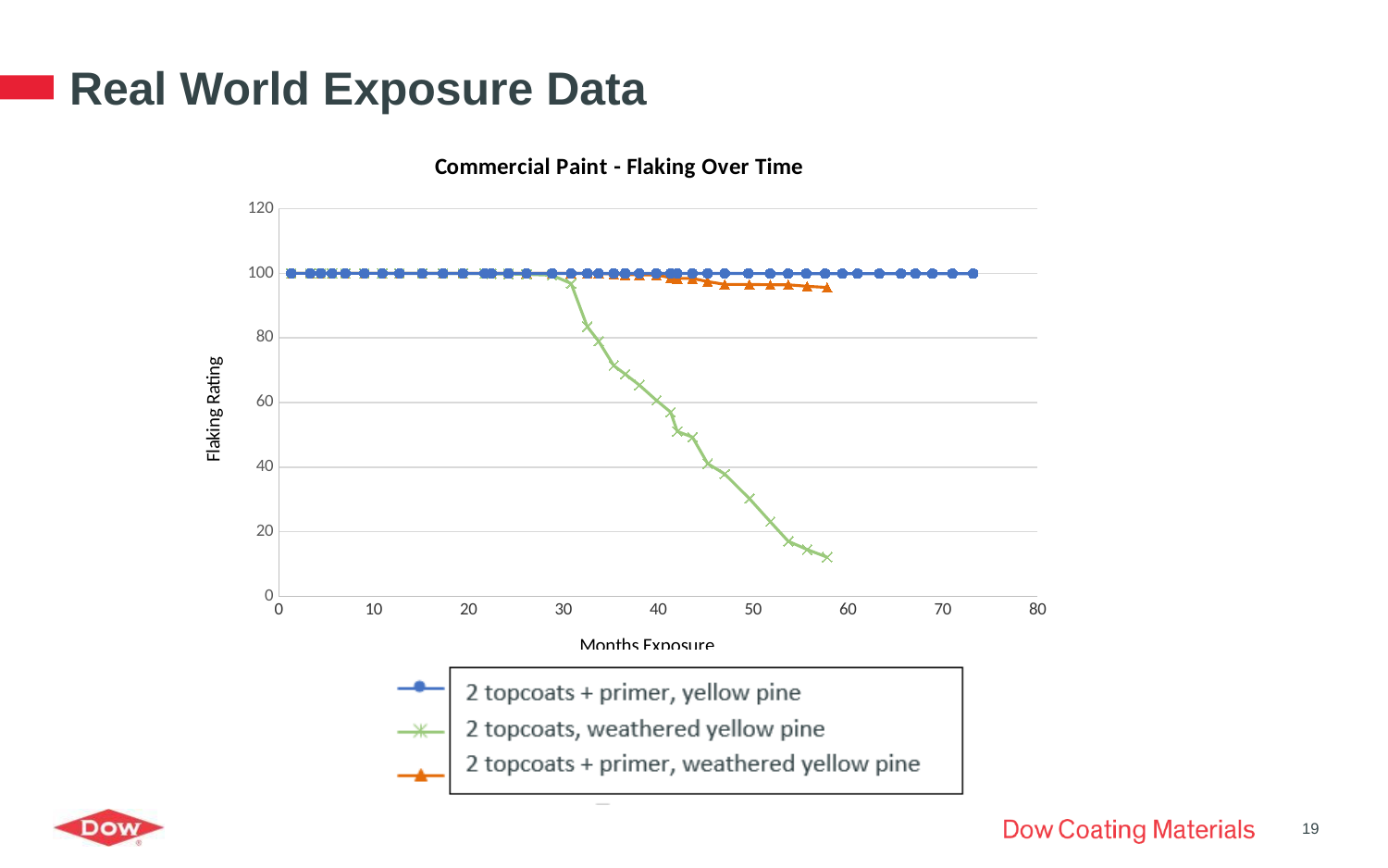
Is the flaking rating for '2 topcoats, weathered yellow pine' at 50 months exposure greater or less than 40? less What is the title of the chart? Commercial Paint - Flaking Over Time What is the label of the vertical axis? Flaking Rating Is the flaking rating for '2 topcoats + primer, weathered yellow pine' at 55 months exposure greater or less than 80? greater Which series reaches the lowest flaking rating on the chart? 2 topcoats, weathered yellow pine How many series does the legend list? 3 Is the flaking rating for '2 topcoats + primer, yellow pine' at 70 months exposure greater or less than 80? greater What kind of chart is shown on the slide? line chart Does the flaking rating for '2 topcoats, weathered yellow pine' rise or fall as months of exposure increase beyond 30? fall At 50 months exposure, which series has the higher flaking rating: '2 topcoats + primer, yellow pine' or '2 topcoats, weathered yellow pine'? 2 topcoats + primer, yellow pine